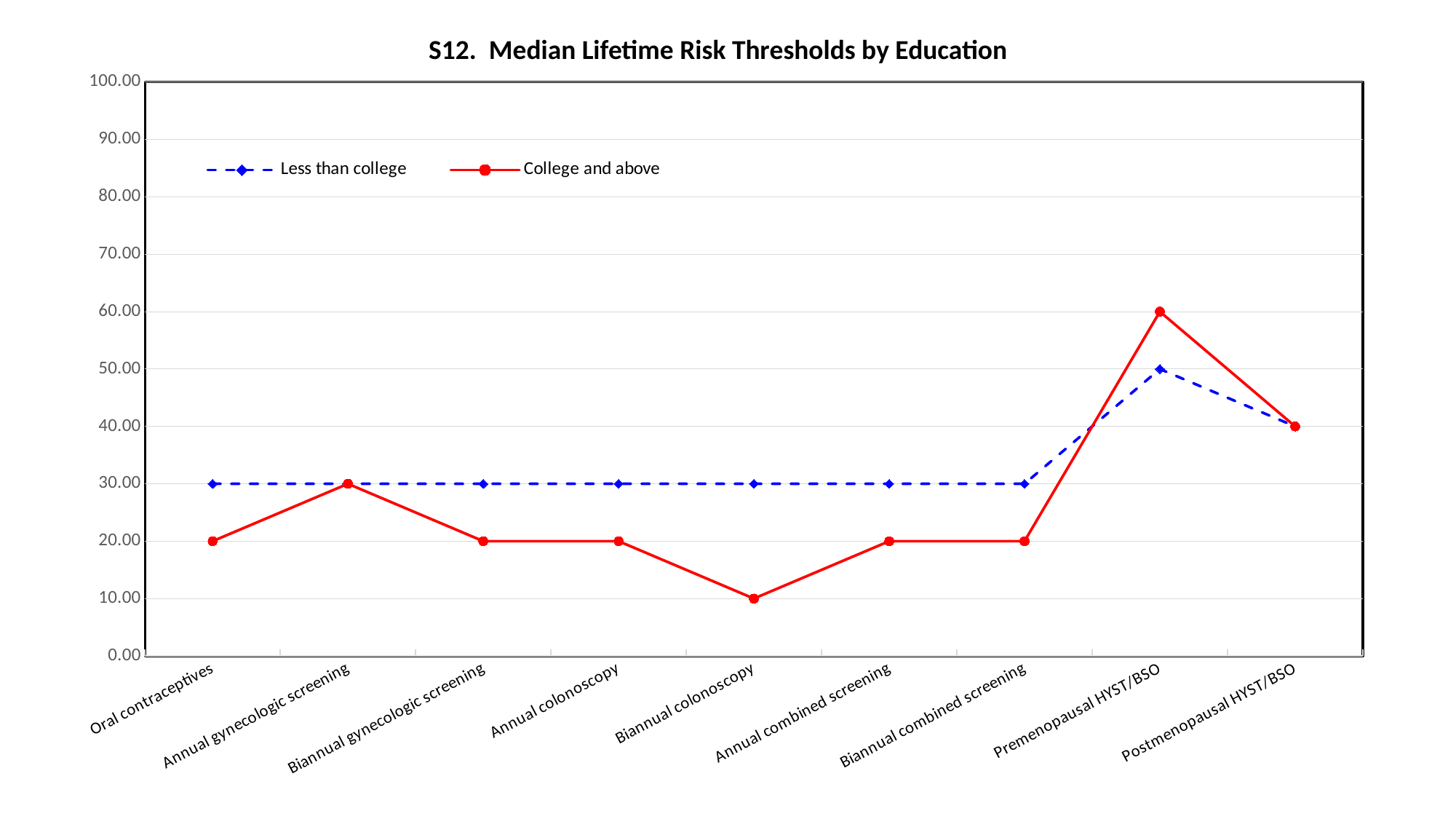
What is the difference between College and above and Less than college at Premenopausal HYST/BSO? 10.00 What is the value for Less than college at Oral contraceptives? 30.00 What kind of chart is shown on the slide? Line chart What is the value for College and above at Biannual colonoscopy? 10.00 What is the value for College and above at Premenopausal HYST/BSO? 60.00 Which category has the lowest value for the College and above series? Biannual colonoscopy How many series does the legend list? 2 Which category has the highest value for the College and above series? Premenopausal HYST/BSO What is the title of the chart? S12. Median Lifetime Risk Thresholds by Education At Oral contraceptives, which series has the larger value, Less than college or College and above? Less than college What is the value for Less than college at Premenopausal HYST/BSO? 50.00 How many categories are shown on the x axis? 9